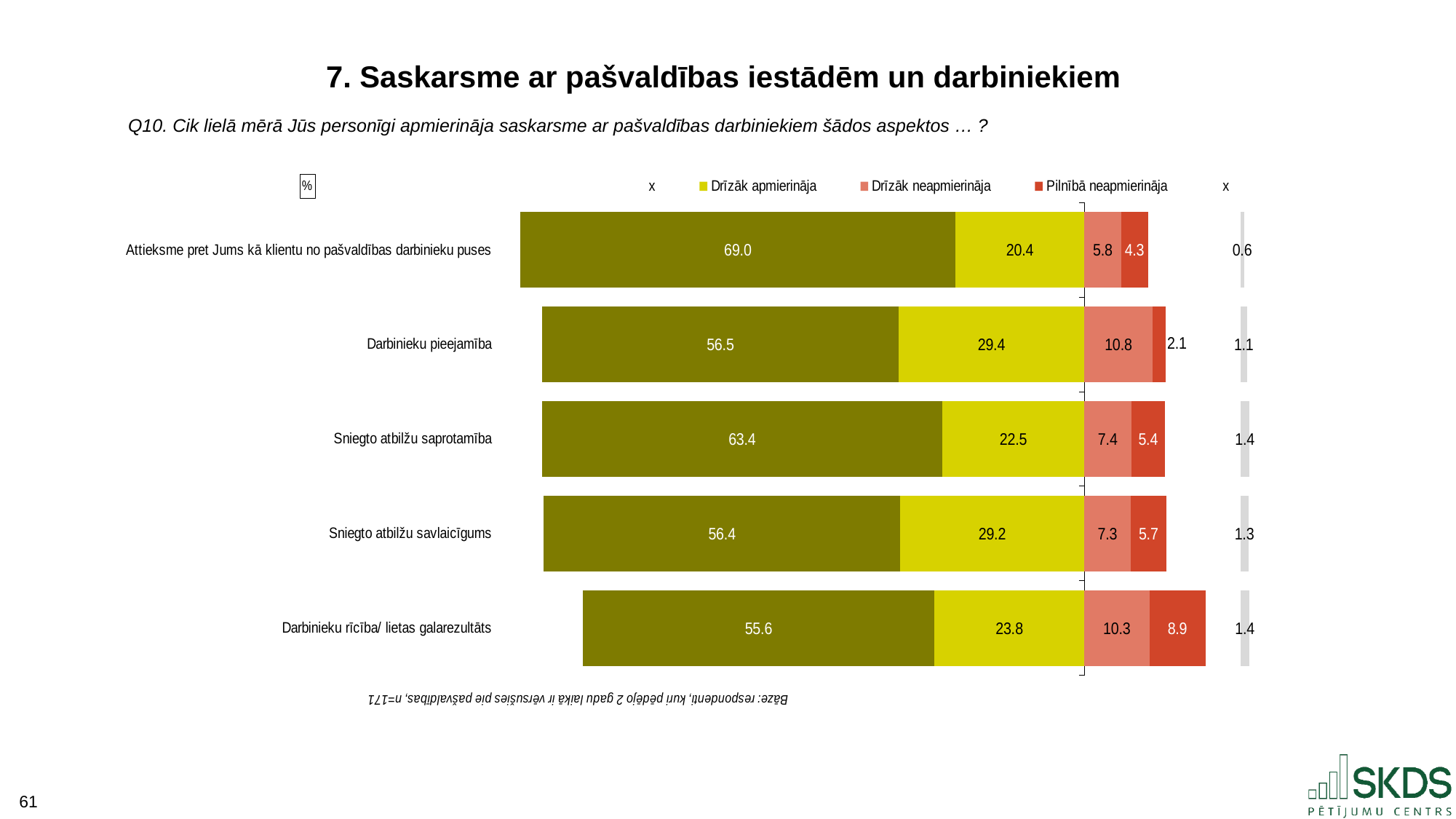
What is the value of "Drīzāk neapmierināja" for "Sniegto atbilžu saprotamība"? 7.4 Which category has the highest value for "Pilnībā neapmierināja"? Darbinieku rīcība/ lietas galarezultāts What colour represents "Pilnībā neapmierināja" in the legend? Red What is the value of "Drīzāk apmierināja" for "Darbinieku pieejamība"? 29.4 What is the difference between the "Drīzāk neapmierināja" values for "Darbinieku pieejamība" and "Attieksme pret Jums kā klientu no pašvaldības darbinieku puses"? 5.0 Which category has the lowest value for "Drīzāk apmierināja"? Attieksme pret Jums kā klientu no pašvaldības darbinieku puses Which has the larger "Pilnībā neapmierināja" value: "Sniegto atbilžu savlaicīgums" or "Sniegto atbilžu saprotamība"? Sniegto atbilžu savlaicīgums Which category has the lowest value for "Pilnībā neapmierināja"? Darbinieku pieejamība What is the value of "Drīzāk apmierināja" for "Sniegto atbilžu savlaicīgums"? 29.2 What kind of chart is shown on the slide? Stacked bar chart How many categories are shown in the chart? 5 What is the value of "Pilnībā neapmierināja" for "Darbinieku rīcība/ lietas galarezultāts"? 8.9